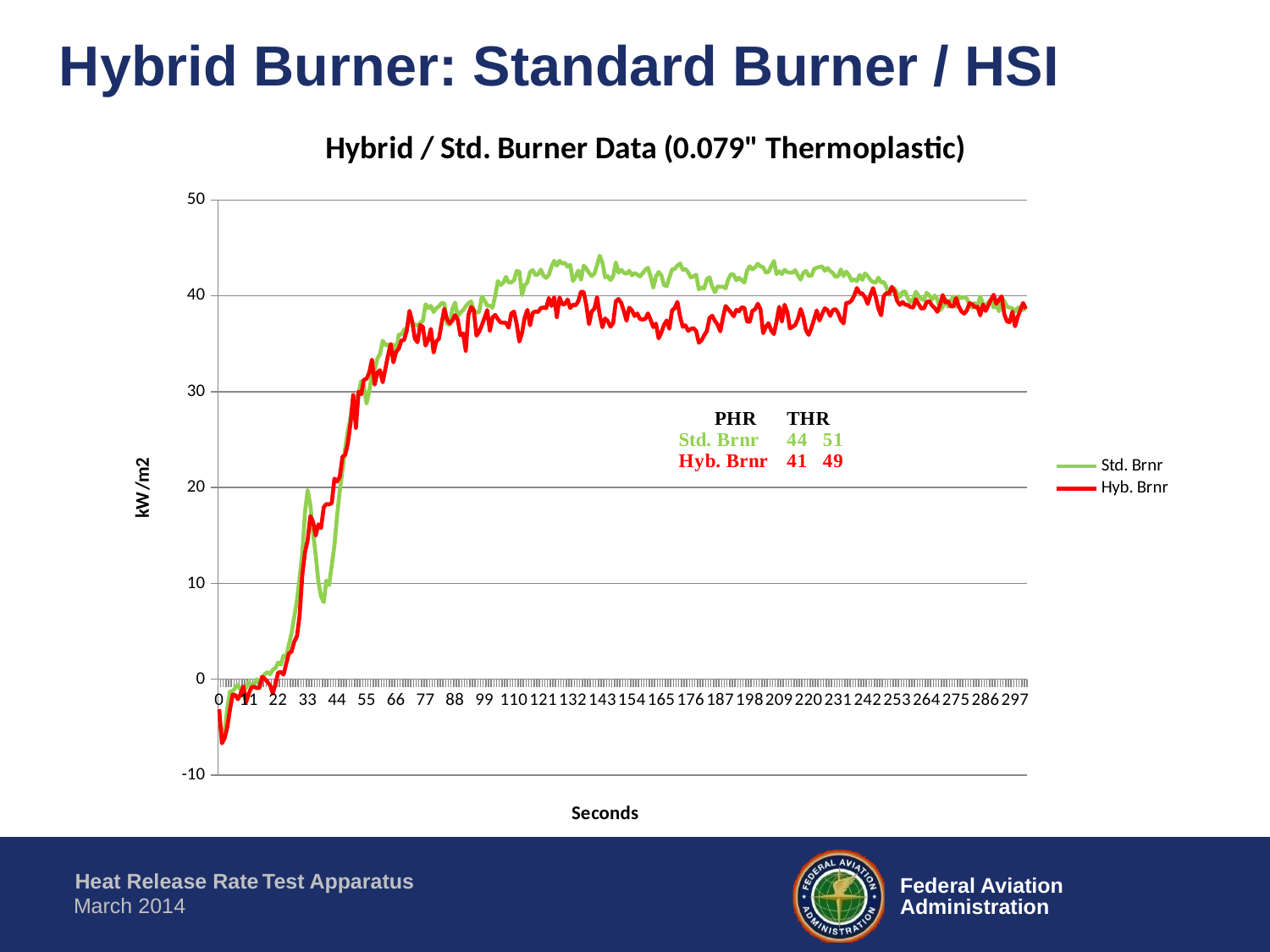
Is the value for Hyb. Brnr at 176 seconds greater or less than 40? less Do the values for Hyb. Brnr rise or fall between 22 and 66 seconds? rise Which series has the higher PHR value in the annotation, Std. Brnr or Hyb. Brnr? Std. Brnr Is the value for Std. Brnr at 143 seconds greater or less than 40? greater What kind of chart is shown on the slide? line chart According to the annotation on the chart, what is the PHR value for Std. Brnr? 44 What is the label on the vertical axis of the chart? kW/m2 According to the annotation on the chart, what is the THR value for Hyb. Brnr? 49 What is the difference between the PHR values of Std. Brnr and Hyb. Brnr shown in the annotation? 3 How many series does the legend list? 2 According to the annotation on the chart, what is the THR value for Std. Brnr? 51 What is the title of the chart? Hybrid / Std. Burner Data (0.079" Thermoplastic)